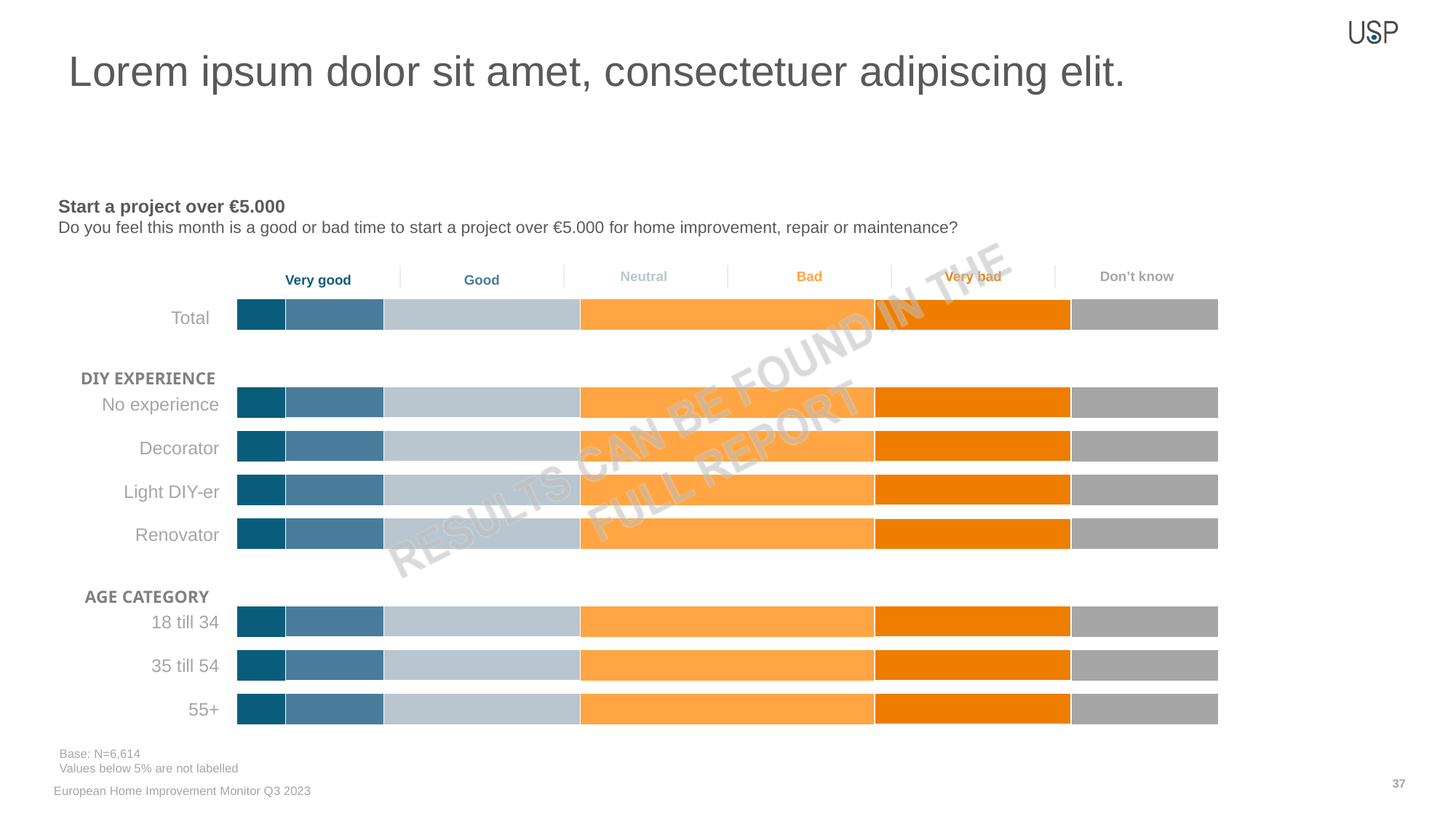
How many bars (rows) are plotted in the chart? 8 How many categories are listed under the AGE CATEGORY group in the chart? 3 How many categories are listed under the DIY EXPERIENCE group in the chart? 4 In the Renovator bar, which segment is the widest? Bad What kind of chart is shown on the slide? Stacked bar chart What is the title of the chart? Start a project over €5.000 How many response categories does the legend of the chart list? 6 Which response category is listed first in the chart's legend? Very good In the 55+ bar, which segment is larger: Good or Don't know? Don't know In the 18 till 34 bar, which segment is the narrowest? Very good In the Total bar, which segment is larger: Very good or Neutral? Neutral In the Total bar, which segment is larger: Bad or Very bad? Bad